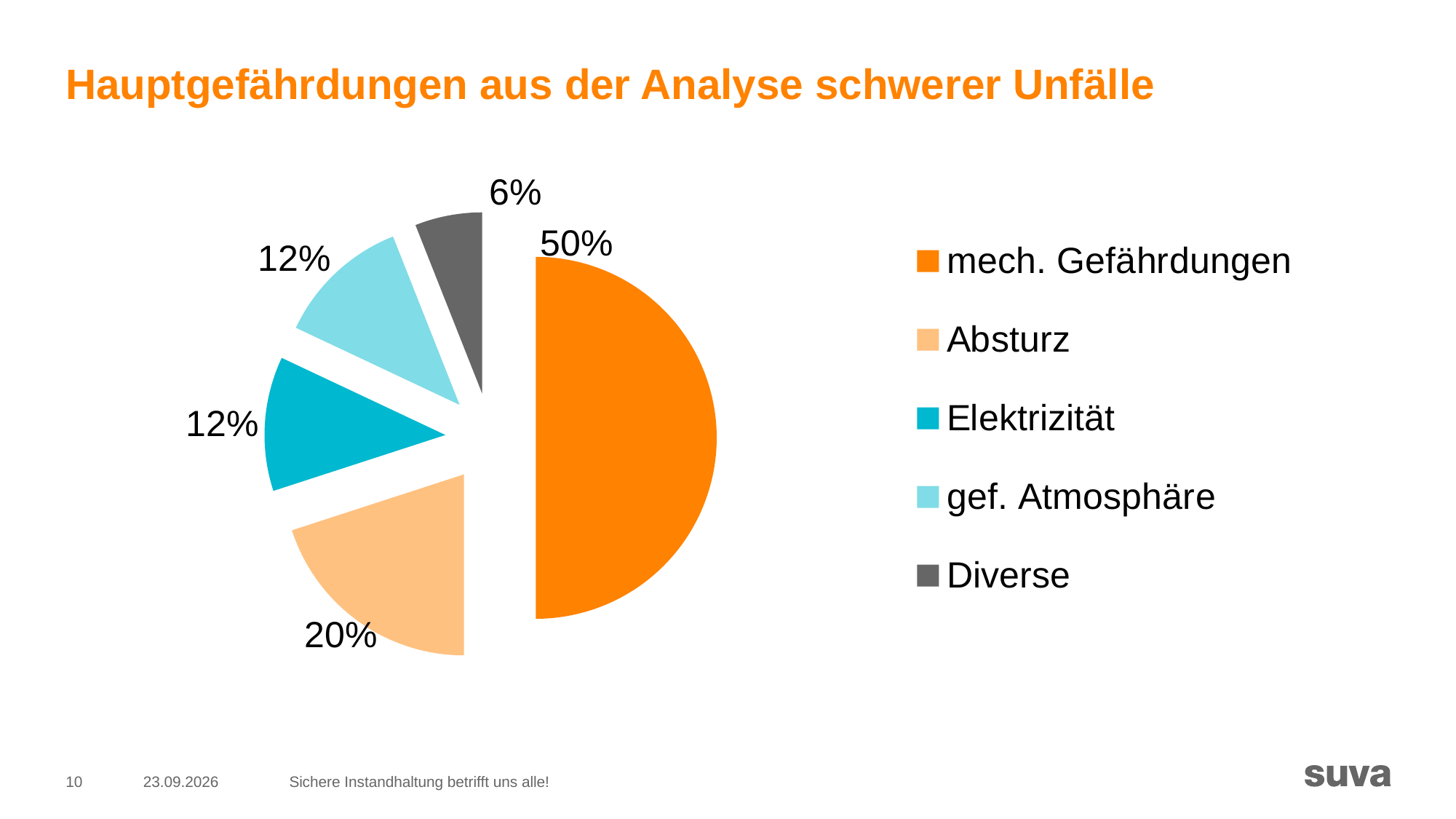
What is the title of the chart? Hauptgefährdungen aus der Analyse schwerer Unfälle Which category has the smallest slice of the pie? Diverse What share of the pie does mech. Gefährdungen have? 50% What is the difference between the shares of mech. Gefährdungen and Absturz? 30% What colour is the slice for Diverse? grey What kind of chart is shown on the slide? pie chart How many categories does the pie chart show? 5 What is the value shown for Diverse? 6% Which category has the largest slice of the pie? mech. Gefährdungen What is the value shown for Elektrizität? 12% What is the value shown for Absturz? 20% Which is larger, the share for Absturz or the share for gef. Atmosphäre? Absturz